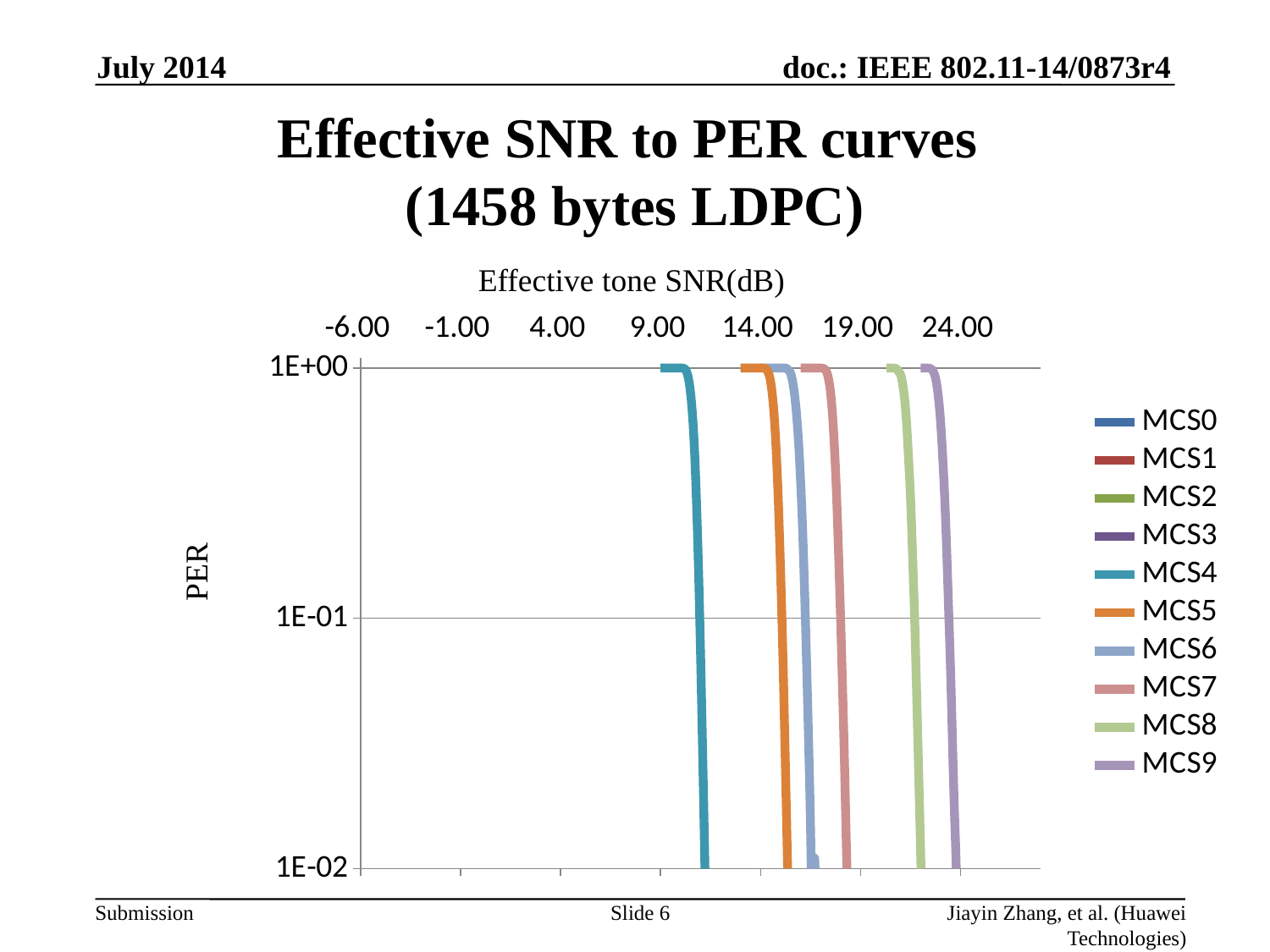
Among the curves plotted, which series reaches a PER of 1E-01 at the lowest SNR? MCS4 As the effective tone SNR increases along the x axis, does the PER of each curve rise or fall? fall What is the title of the chart on the slide? Effective SNR to PER curves (1458 bytes LDPC) What is the label of the horizontal axis? Effective tone SNR(dB) Which series reaches a PER of 1E-01 at a lower SNR, MCS6 or MCS7? MCS6 Which series reaches a PER of 1E-01 at a higher SNR, MCS5 or MCS8? MCS8 Is the SNR at which the MCS9 curve crosses a PER of 1E-01 greater or less than 19.00 dB? greater Is the SNR at which the MCS4 curve crosses a PER of 1E-01 greater or less than 14.00 dB? less Which series' curve lies furthest to the right, i.e. requires the highest SNR to reach a PER of 1E-01? MCS9 What kind of chart is shown on the slide? line chart How many series does the legend list? 10 Is the SNR at which the MCS8 curve crosses a PER of 1E-01 greater or less than 19.00 dB? greater